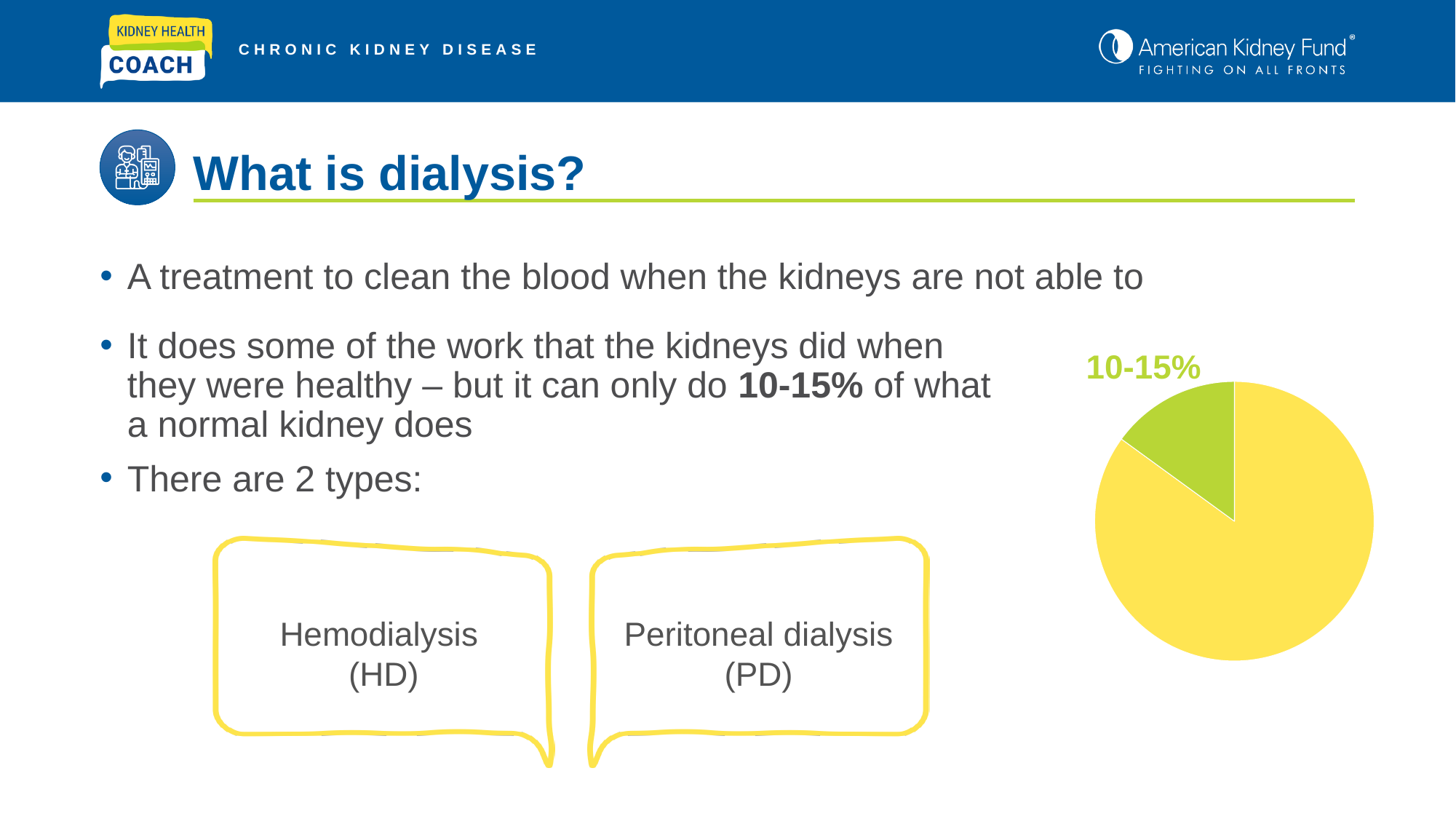
What kind of chart is shown on the right side of the slide? pie chart What colour is the slice labelled 10-15% in the pie chart? green What colour is the largest slice of the pie chart? yellow Which slice of the pie chart is the smallest? the green slice (10-15%) Which slice of the pie chart is larger, the yellow one or the green one? yellow What share of the pie does the green slice represent, according to its label? 10-15% How many slices does the pie chart have? 2 What label is printed next to the small green slice of the pie chart? 10-15%